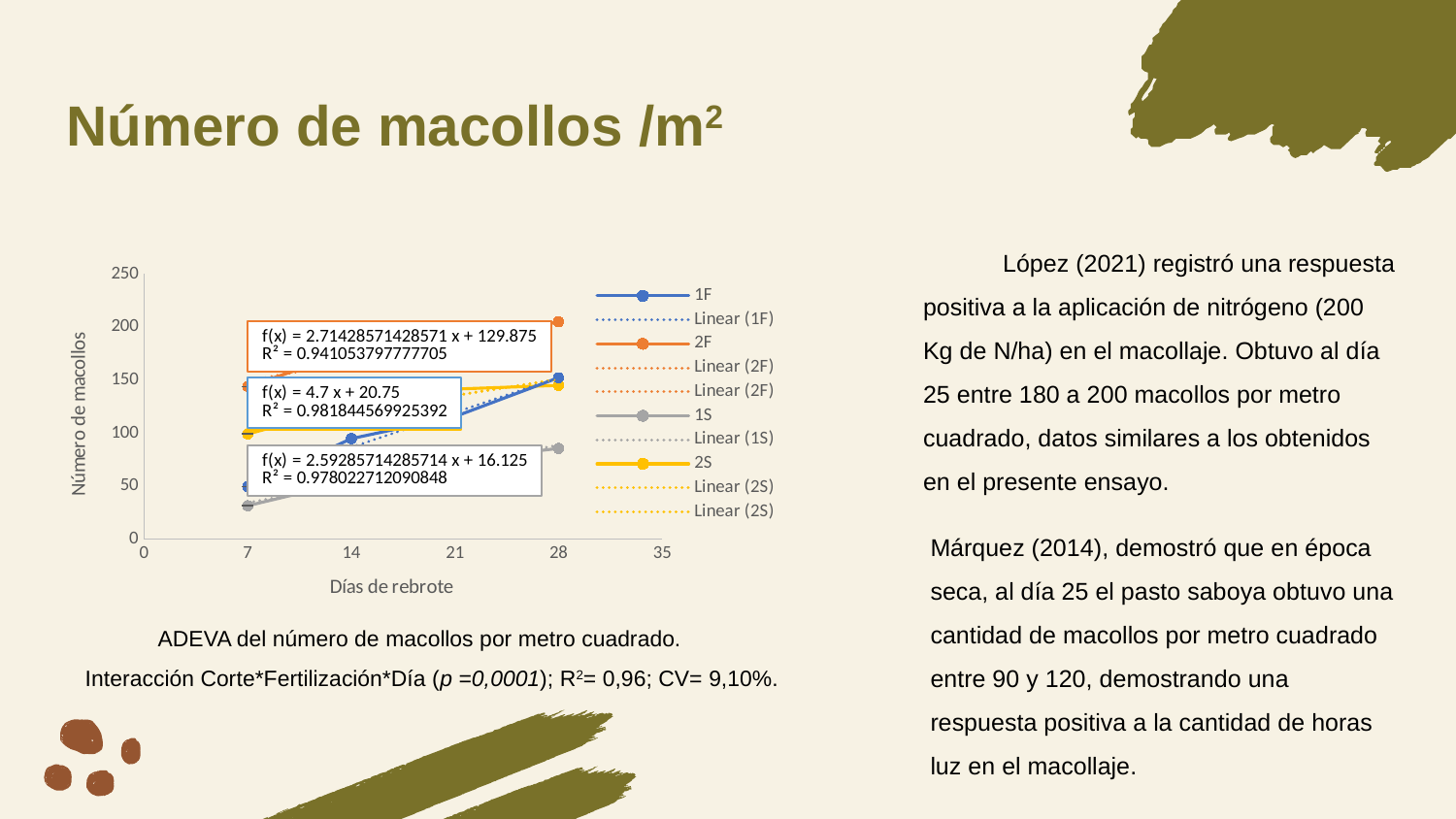
What is the title of the x axis of the chart? Días de rebrote Which series has the lowest value at day 28? 1S Do the values for series 1F rise or fall from day 7 to day 28? rise Is the value for 2F at day 28 greater or less than 150? greater Is the value for 2F at day 7 greater or less than 100? greater Is the value for 1F at day 7 greater or less than 100? less Which is larger at day 7, the value for 2S or the value for 1S? 2S What kind of chart is shown on the slide? line chart What is the title of the y axis of the chart? Número de macollos Which series has the highest value at day 28? 2F